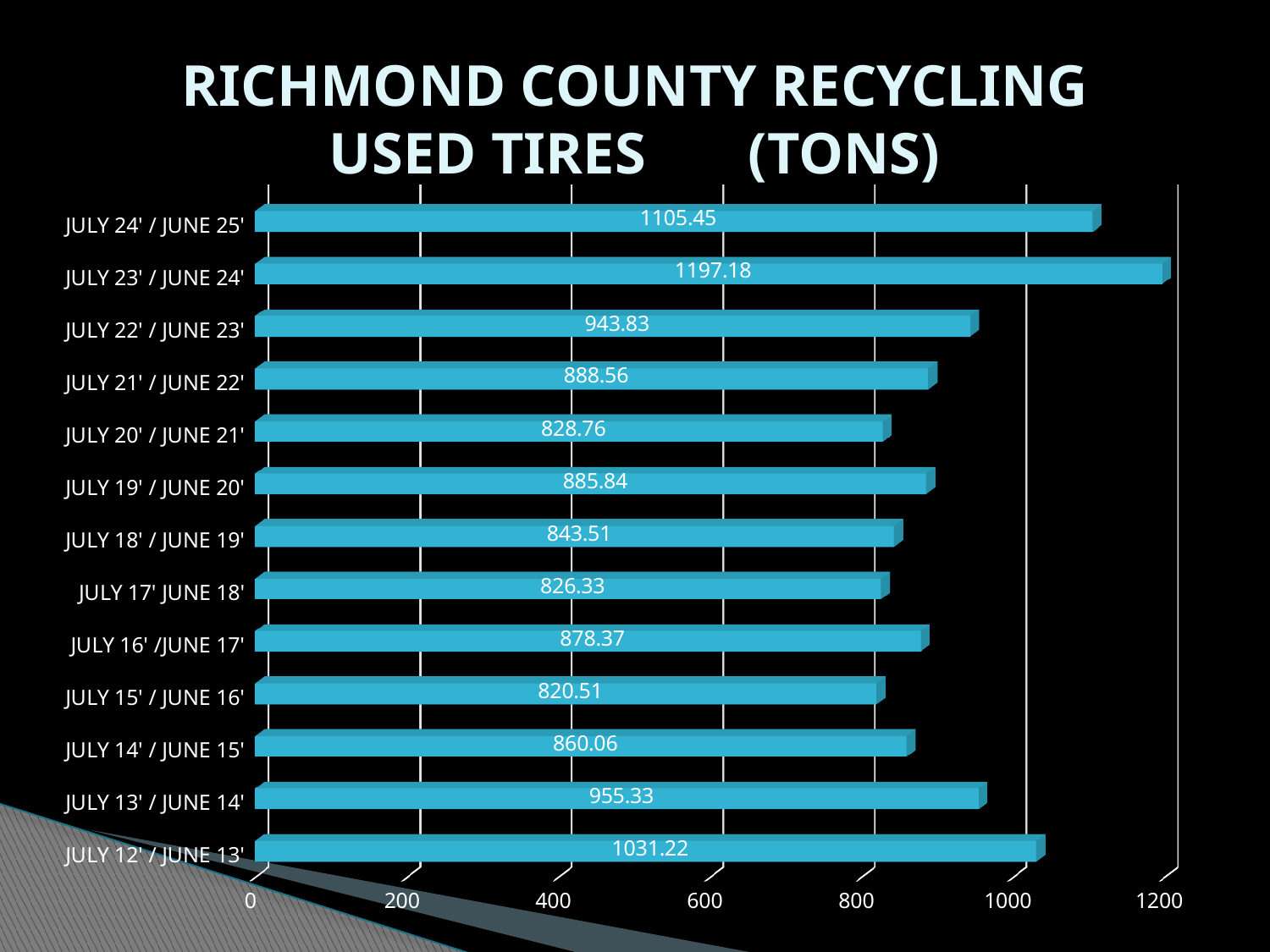
What is the value for JULY 12' / JUNE 13'? 1031.22 How many periods are shown in the chart? 13 Is the value for JULY 22' / JUNE 23' greater or less than 800? greater Which period has the lowest value? JULY 15' / JUNE 16' Which period has the highest value? JULY 23' / JUNE 24' What is the value for JULY 18' / JUNE 19'? 843.51 What is the difference between the values for JULY 23' / JUNE 24' and JULY 24' / JUNE 25'? 91.73 What kind of chart is shown on the slide? bar chart What is the difference between the values for JULY 12' / JUNE 13' and JULY 13' / JUNE 14'? 75.89 Which is larger, the value for JULY 13' / JUNE 14' or JULY 14' / JUNE 15'? JULY 13' / JUNE 14' What is the value for JULY 24' / JUNE 25'? 1105.45 What is the title of the chart? RICHMOND COUNTY RECYCLING USED TIRES (TONS)